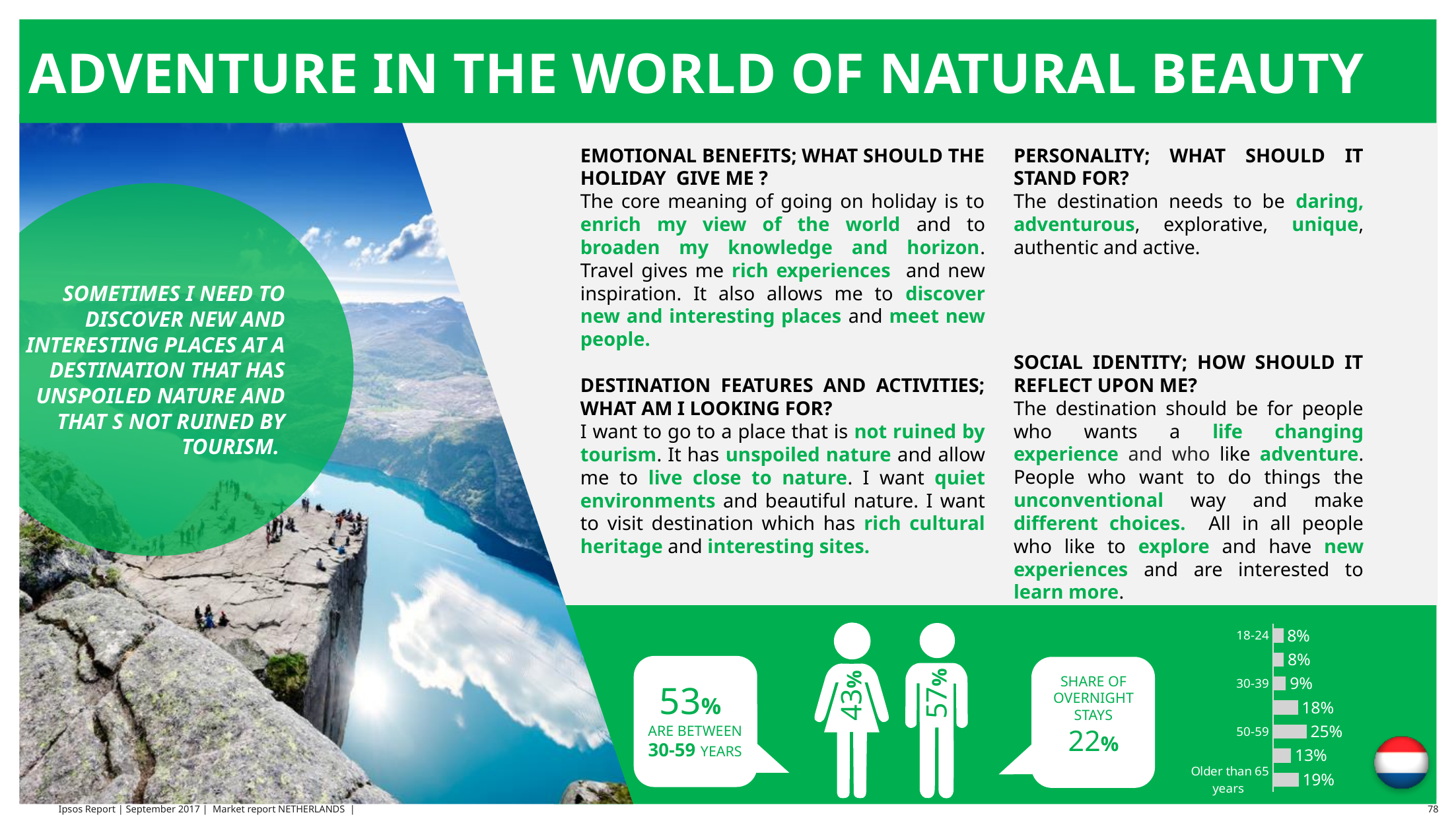
In the age-group bar chart at the bottom right, what is the value for 18-24? 8% In the age-group bar chart at the bottom right, what is the lowest value shown on any bar? 8% In the age-group bar chart at the bottom right, which is larger: the value for 50-59 or for Older than 65 years? 50-59 How many bars are shown in the age-group bar chart at the bottom right? 7 In the age-group bar chart at the bottom right, what is the value for 30-39? 9% What kind of chart is the age-group chart at the bottom right of the slide? Bar chart In the age-group bar chart at the bottom right, what is the difference between the values for Older than 65 years and 30-39? 10 percentage points In the age-group bar chart at the bottom right, what is the value for 50-59? 25% In the age-group bar chart at the bottom right, which labelled age group has the highest value? 50-59 In the age-group bar chart at the bottom right, what is the difference between the values for 50-59 and 18-24? 17 percentage points In the age-group bar chart at the bottom right, which is larger: the value for 18-24 or for 30-39? 30-39 In the age-group bar chart at the bottom right, what is the value for Older than 65 years? 19%